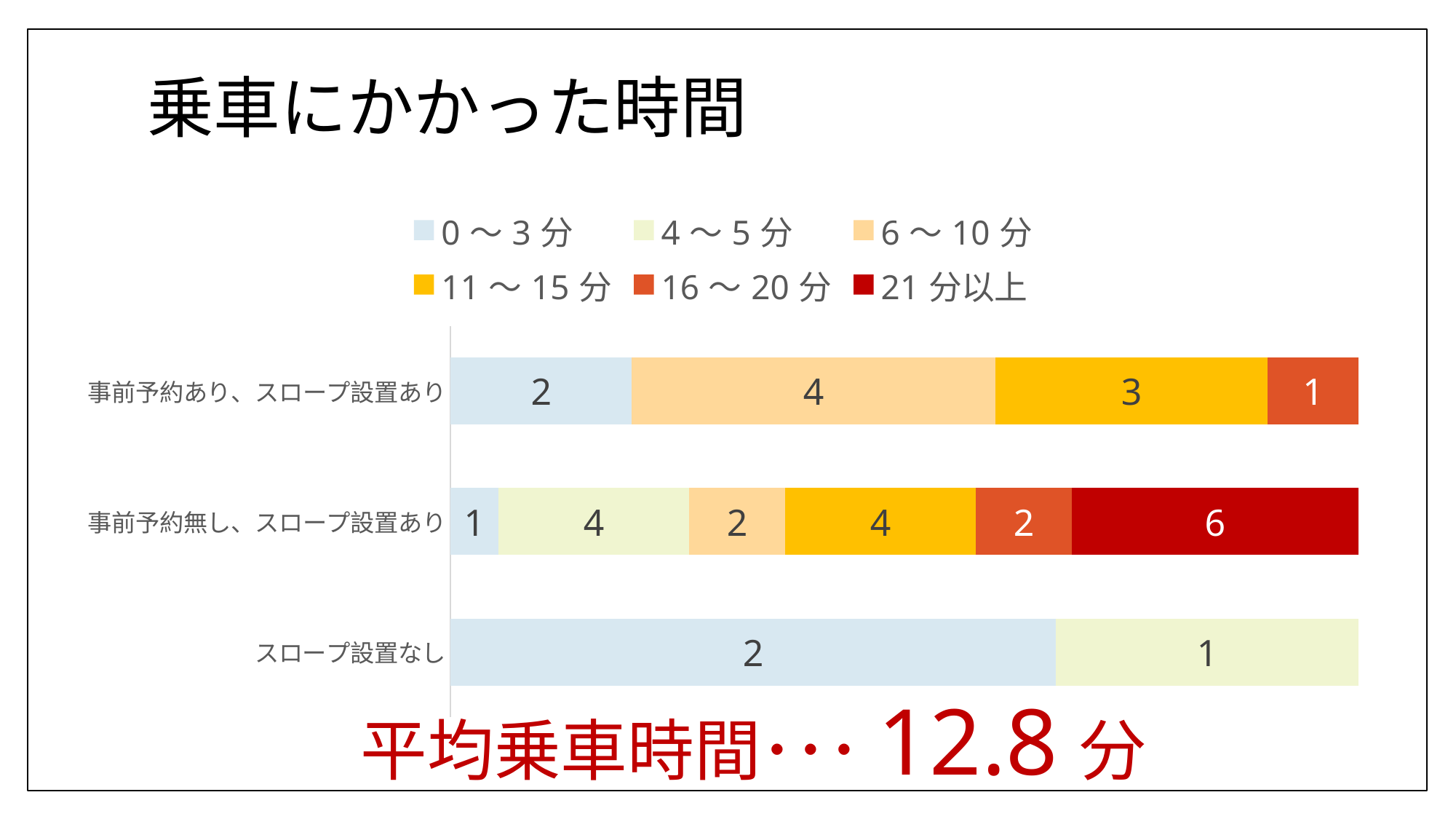
What is the value of the 6～10分 segment for 事前予約あり、スロープ設置あり? 4 How many series does the legend list? 6 What is the value of the 0～3分 segment for スロープ設置なし? 2 What is the difference between the 11～15分 values for 事前予約無し、スロープ設置あり and 事前予約あり、スロープ設置あり? 1 What is the title of the chart? 乗車にかかった時間 What kind of chart is shown on the slide? Stacked bar chart What is the total of the stacked bar for 事前予約無し、スロープ設置あり? 19 What is the value of the 21分以上 segment for 事前予約無し、スロープ設置あり? 6 How many categories are plotted on the chart? 3 Which is larger: the 16～20分 value for 事前予約あり、スロープ設置あり or for 事前予約無し、スロープ設置あり? 事前予約無し、スロープ設置あり Which category has the largest 21分以上 segment? 事前予約無し、スロープ設置あり What is the total of the stacked bar for 事前予約あり、スロープ設置あり? 10